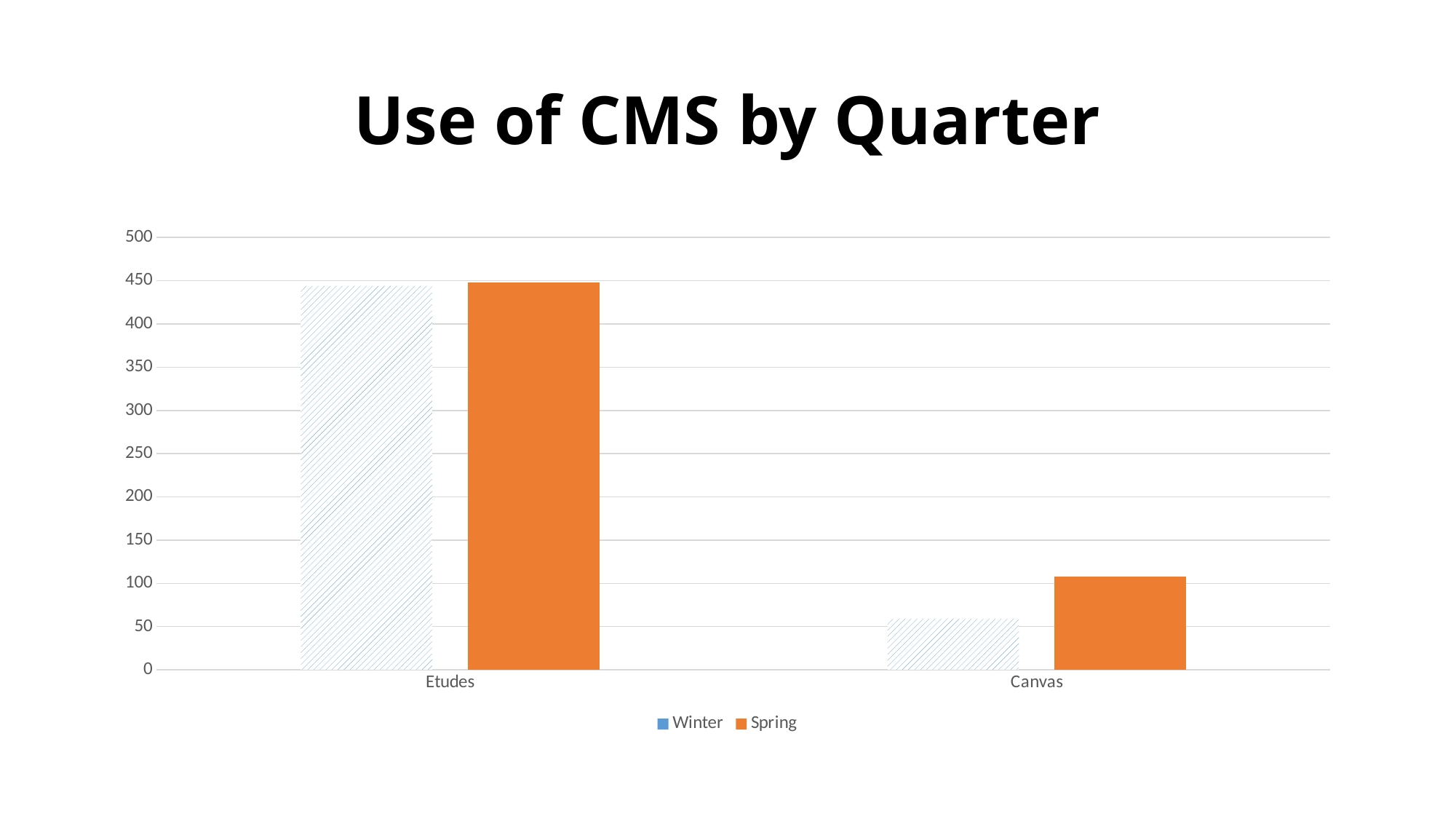
How many categories are shown on the x axis? 2 Is the Winter value for Canvas greater or less than 100? less What kind of chart is shown on the slide? bar chart What is the title of the chart? Use of CMS by Quarter Is the Spring value for Canvas greater or less than 150? less Which series is shown in orange? Spring For Canvas, which is larger, the Winter value or the Spring value? Spring Which category has the highest Spring value? Etudes For the Spring series, which is larger, Etudes or Canvas? Etudes Which category has the lowest Winter value? Canvas How many series does the legend list? 2 Is the Winter value for Etudes greater or less than 400? greater